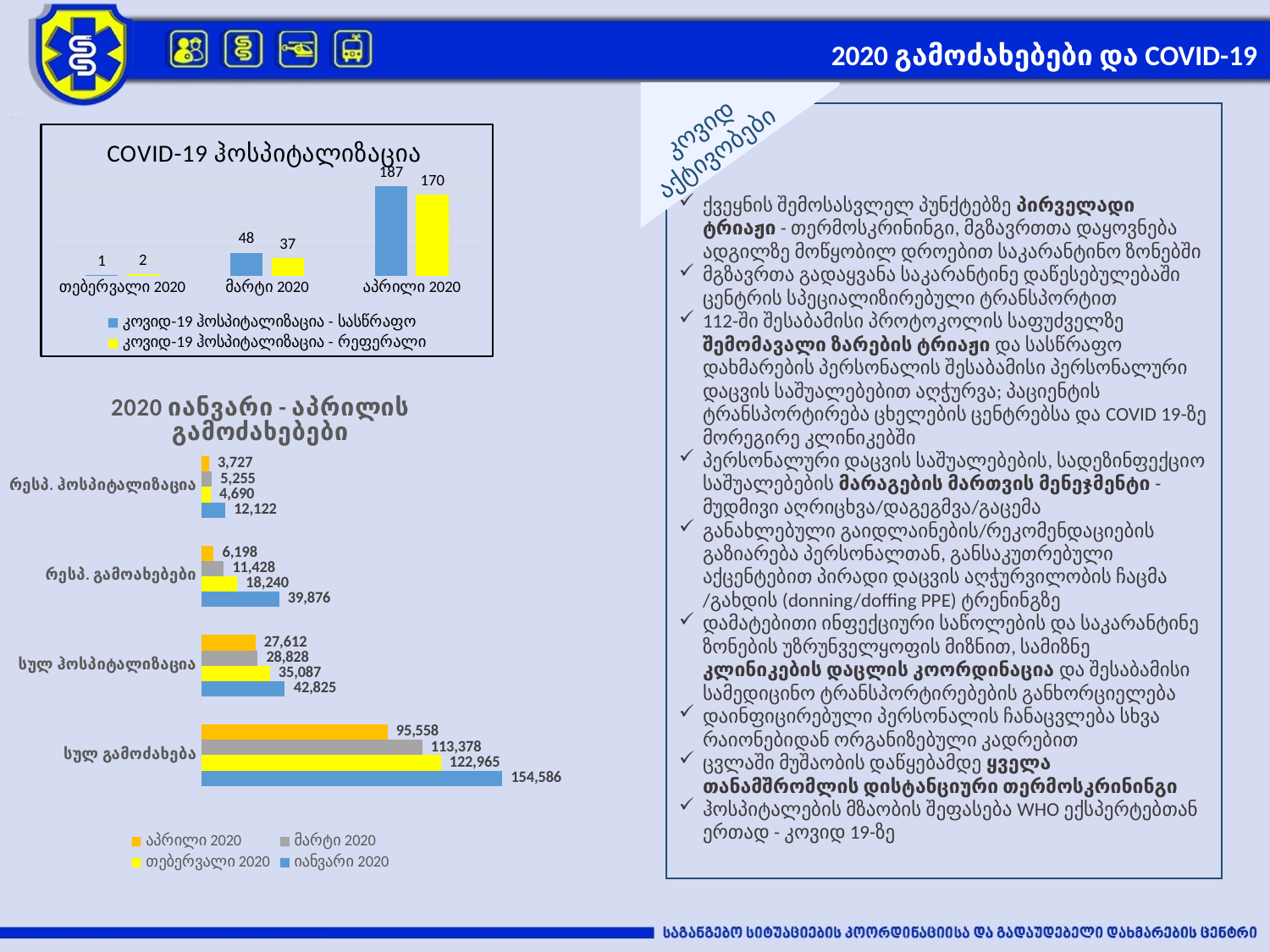
In the '2020 იანვარი - აპრილის გამოძახებები' chart, what is the difference between the იანვარი 2020 and აპრილი 2020 values for 'სულ გამოძახება'? 59,028 In the '2020 იანვარი - აპრილის გამოძახებები' chart, which month has the highest value in the 'სულ ჰოსპიტალიზაცია' category? იანვარი 2020 What kind of chart is '2020 იანვარი - აპრილის გამოძახებები'? bar chart In the '2020 იანვარი - აპრილის გამოძახებები' chart, which month has the lowest value in the 'რესპ. გამოძახებები' category? აპრილი 2020 In the 'COVID-19 ჰოსპიტალიზაცია' chart, how many series does the legend list? 2 In the '2020 იანვარი - აპრილის გამოძახებები' chart, what is the value for აპრილი 2020 in the 'რესპ. ჰოსპიტალიზაცია' category? 3,727 In the 'COVID-19 ჰოსპიტალიზაცია' chart, do the სასწრაფო values rise or fall from თებერვალი 2020 to აპრილი 2020? rise In the 'COVID-19 ჰოსპიტალიზაცია' chart, what is the value for 'კოვიდ-19 ჰოსპიტალიზაცია - რეფერალი' in მარტი 2020? 37 In the '2020 იანვარი - აპრილის გამოძახებები' chart, what is the value for იანვარი 2020 in the 'სულ გამოძახება' category? 154,586 In the 'COVID-19 ჰოსპიტალიზაცია' chart, what is the difference between the სასწრაფო and რეფერალი values in აპრილი 2020? 17 In the '2020 იანვარი - აპრილის გამოძახებები' chart, how many categories are shown on the vertical axis? 4 In the 'COVID-19 ჰოსპიტალიზაცია' chart, what is the value for 'კოვიდ-19 ჰოსპიტალიზაცია - სასწრაფო' in აპრილი 2020? 187